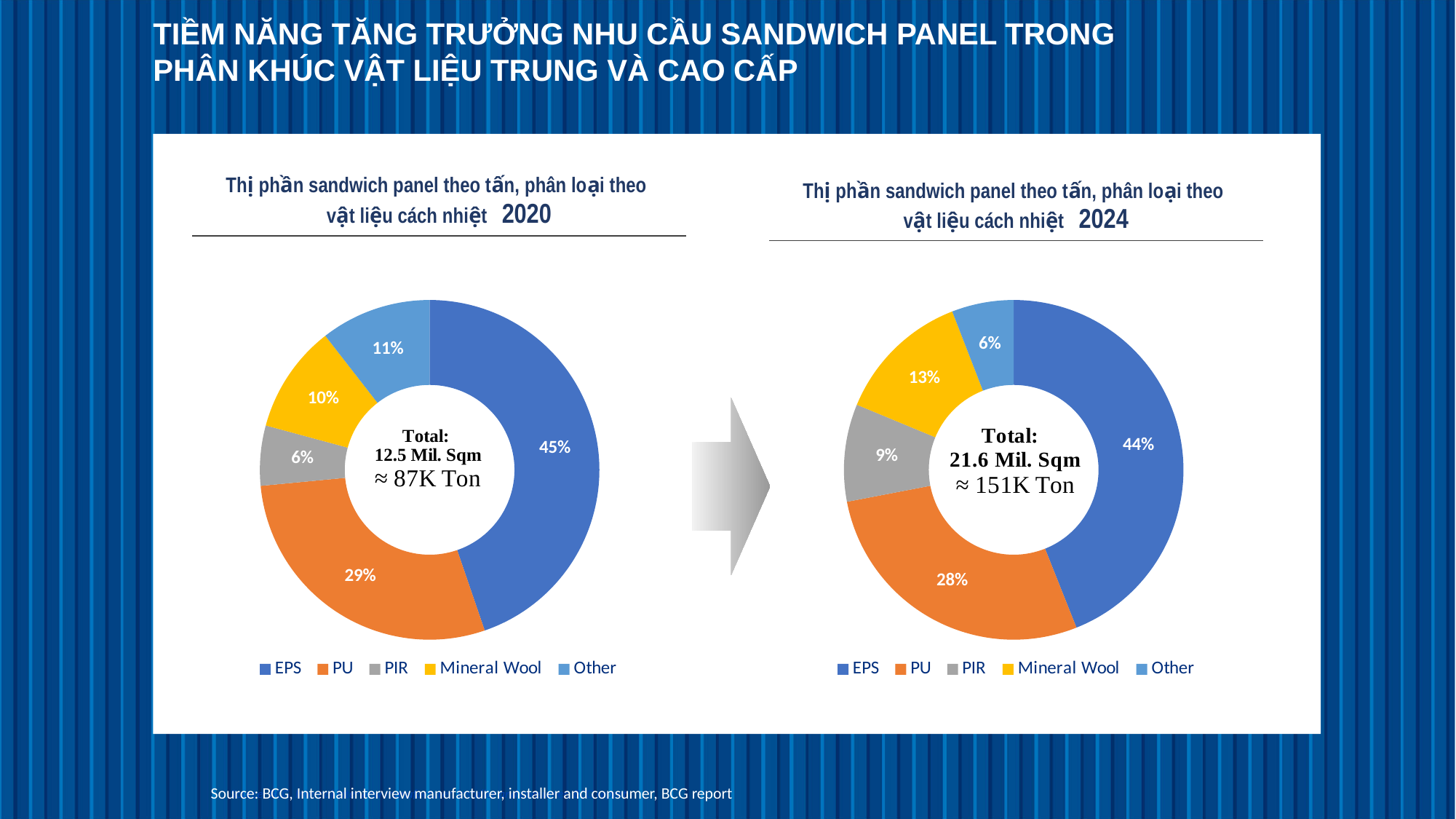
In the 2020 chart, which colour represents PU? Orange What kind of chart is the 2020 chart? Donut (pie) chart In the 2020 chart, what share does PIR hold? 6% In the 2024 chart, which is larger, the share of PIR or the share of Mineral Wool? Mineral Wool In the 2024 chart, what share does Mineral Wool hold? 13% In the 2020 chart, what is the difference between the shares of EPS and PU? 16% In the 2024 chart, what share does Other hold? 6% In the 2020 chart, what share does EPS hold? 45% In the 2024 chart, which material has the largest share? EPS How many categories does the 2024 chart show? 5 What total is shown in the centre of the 2024 chart? 21.6 Mil. Sqm ≈ 151K Ton In the 2020 chart, which material has the smallest share? PIR